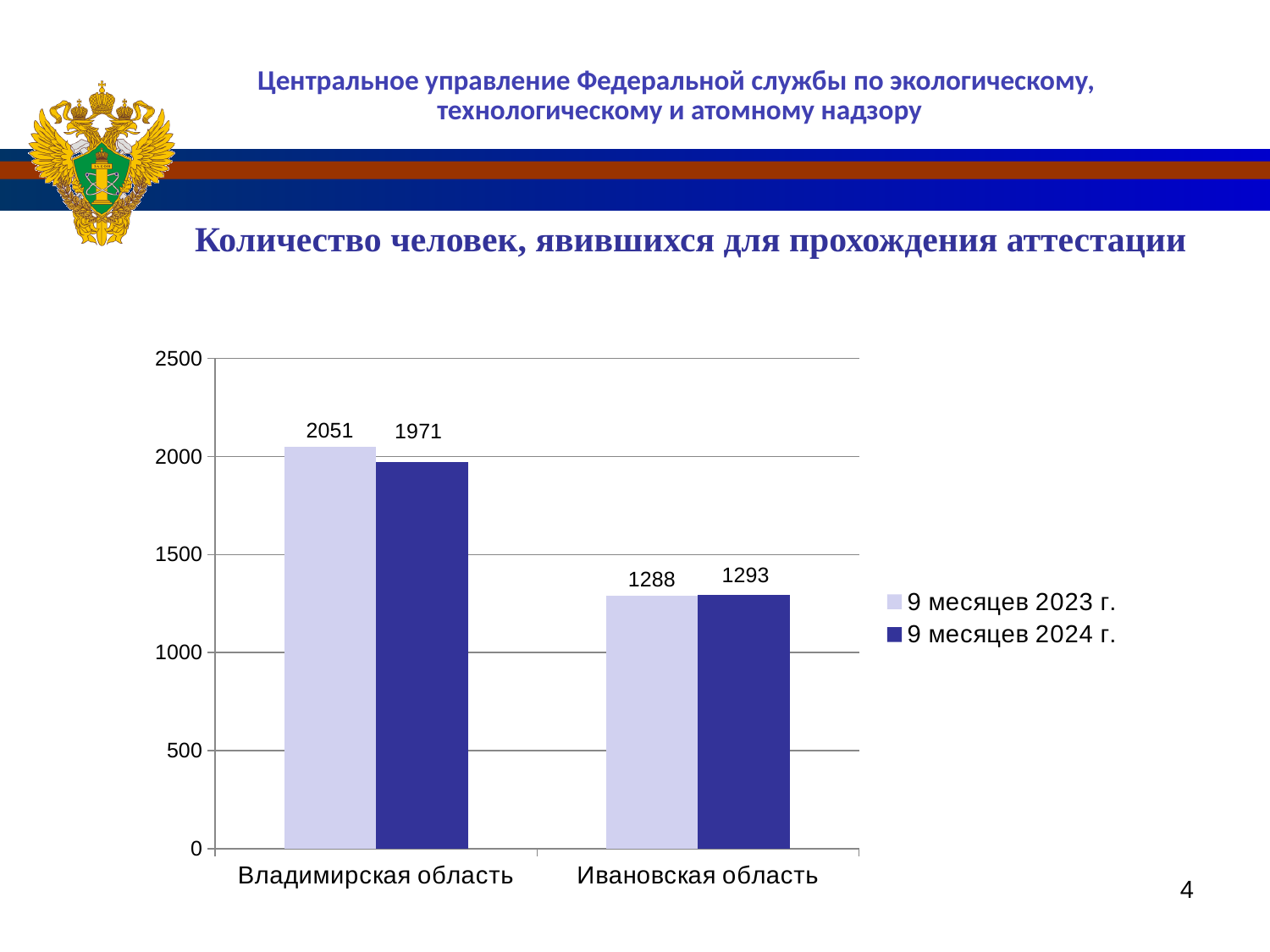
What is the value for Ивановская область in the 9 месяцев 2024 г. series? 1293 What kind of chart is shown on the slide? bar chart What is the value for Владимирская область in the 9 месяцев 2024 г. series? 1971 What is the difference between the 9 месяцев 2024 г. and 9 месяцев 2023 г. values for Ивановская область? 5 Which category has the lowest value in the 9 месяцев 2024 г. series? Ивановская область How many categories are shown on the x axis? 2 What is the difference between the 9 месяцев 2023 г. and 9 месяцев 2024 г. values for Владимирская область? 80 Which category has the highest value in the 9 месяцев 2023 г. series? Владимирская область How many series does the legend list? 2 Is the 9 месяцев 2024 г. value for Владимирская область greater or less than 2000? less What is the value for Владимирская область in the 9 месяцев 2023 г. series? 2051 Which is larger: the 9 месяцев 2023 г. value for Владимирская область or the 9 месяцев 2023 г. value for Ивановская область? Владимирская область